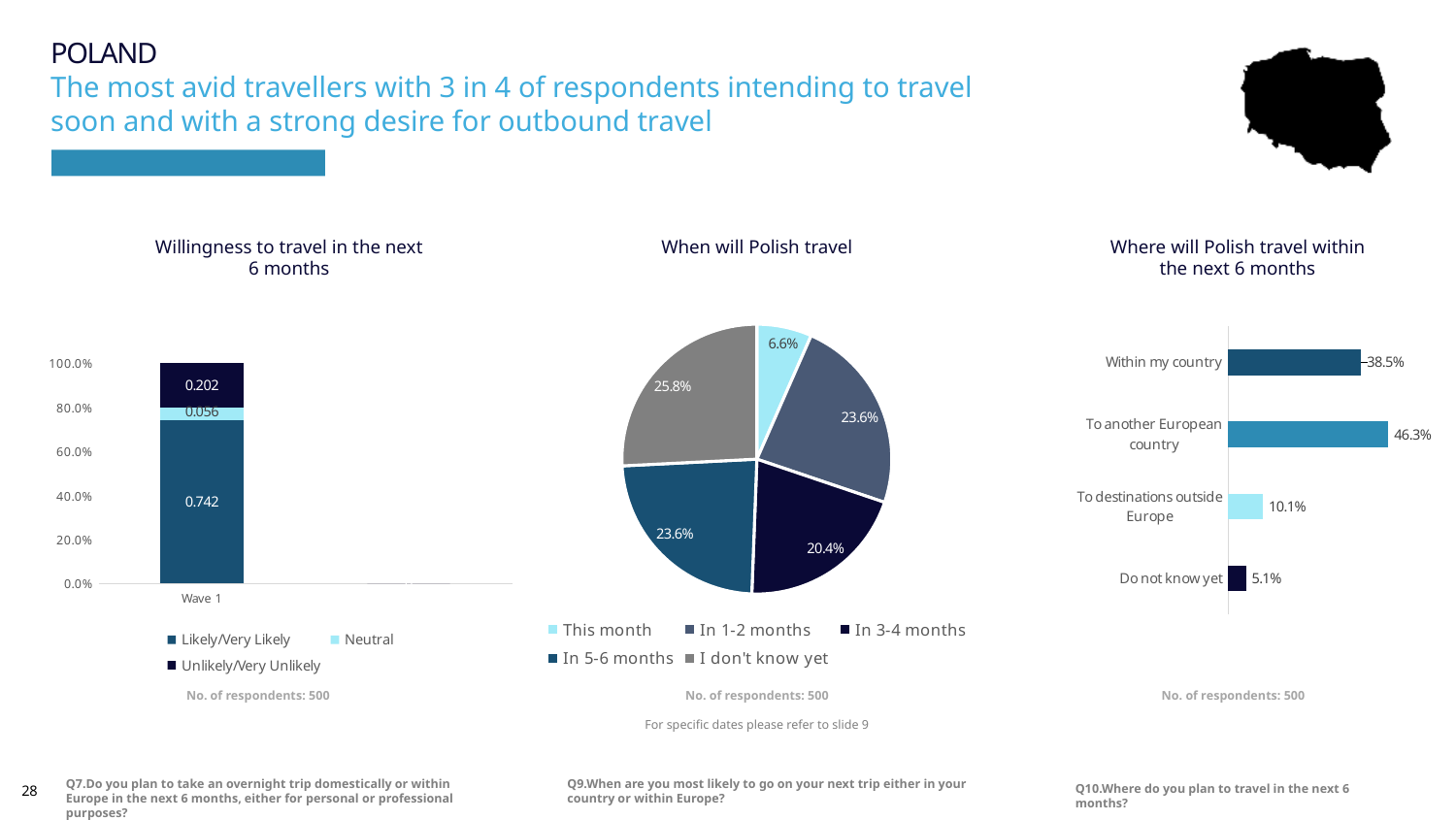
In the 'Willingness to travel in the next 6 months' chart, what is the value for Likely/Very Likely in Wave 1? 0.742 What kind of chart is 'When will Polish travel'? Pie chart In the 'Where will Polish travel within the next 6 months' chart, what is the value for 'To another European country'? 46.3% How many series does the legend of the 'Willingness to travel in the next 6 months' chart list? 3 In the 'Willingness to travel in the next 6 months' chart, what is the value for Unlikely/Very Unlikely? 0.202 In the 'Where will Polish travel within the next 6 months' chart, which category has the lowest value? Do not know yet What kind of chart is 'Where will Polish travel within the next 6 months'? Bar chart In the 'When will Polish travel' pie chart, what share is 'This month'? 6.6% In the 'When will Polish travel' pie chart, which category has the largest share? I don't know yet How many slices does the 'When will Polish travel' pie chart have? 5 In the 'When will Polish travel' pie chart, which category has the smallest share? This month In the 'Where will Polish travel within the next 6 months' chart, what is the difference between 'To another European country' and 'Within my country'? 7.8%